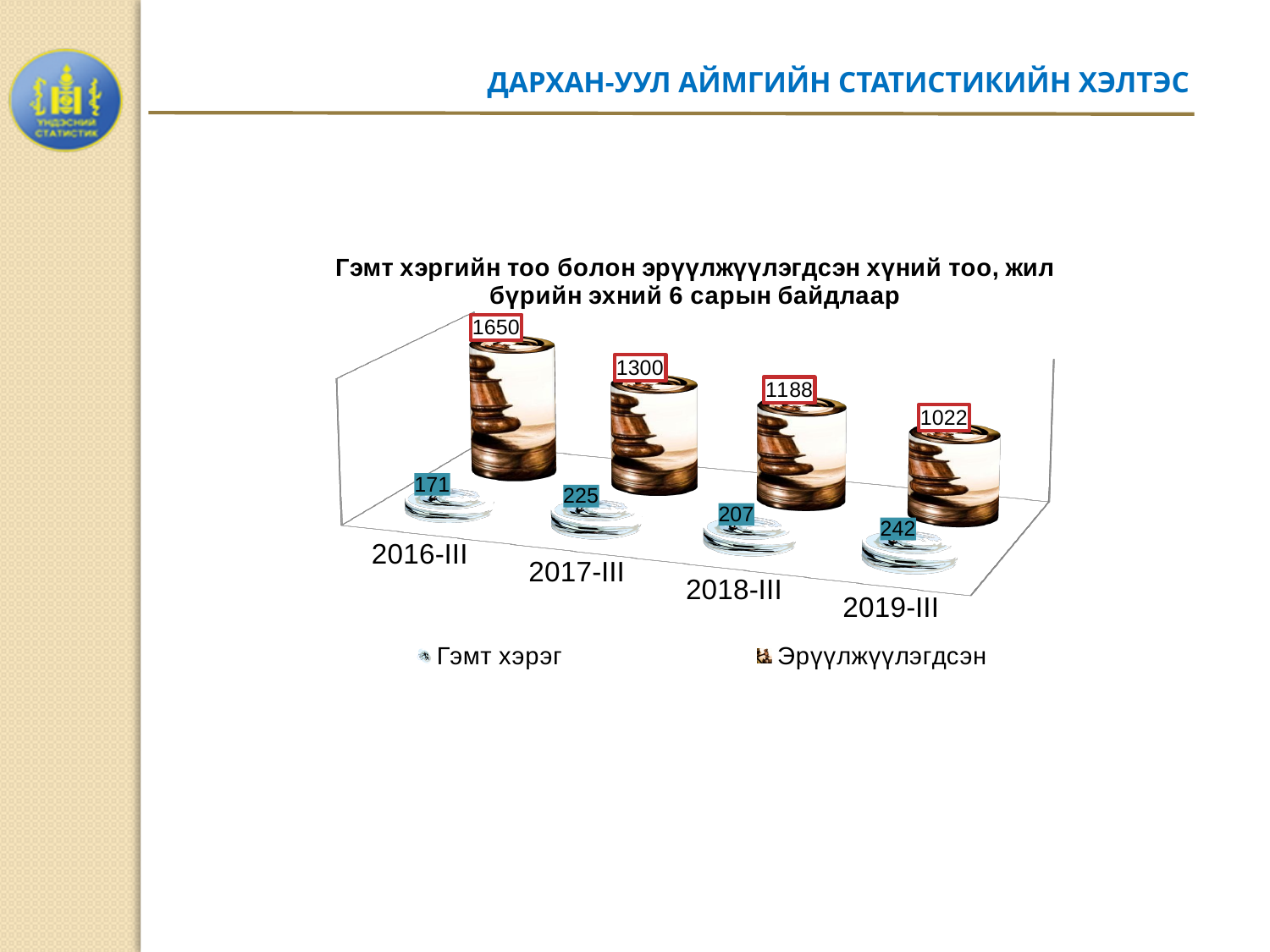
In which period is the Эрүүлжүүлэгдсэн value highest? 2016-III What is the value for Эрүүлжүүлэгдсэн in 2018-III? 1188 Does the Эрүүлжүүлэгдсэн series rise or fall from 2016-III to 2019-III? fall What is the value for Гэмт хэрэг in 2019-III? 242 Which is larger, the Гэмт хэрэг value for 2017-III or for 2018-III? 2017-III How many series does the legend list? 2 What kind of chart is shown on the slide? bar chart What is the value for Гэмт хэрэг in 2017-III? 225 What is the value for Эрүүлжүүлэгдсэн in 2016-III? 1650 What is the difference between the Эрүүлжүүлэгдсэн values for 2016-III and 2019-III? 628 How many periods are shown on the x axis? 4 In which period is the Гэмт хэрэг value lowest? 2016-III